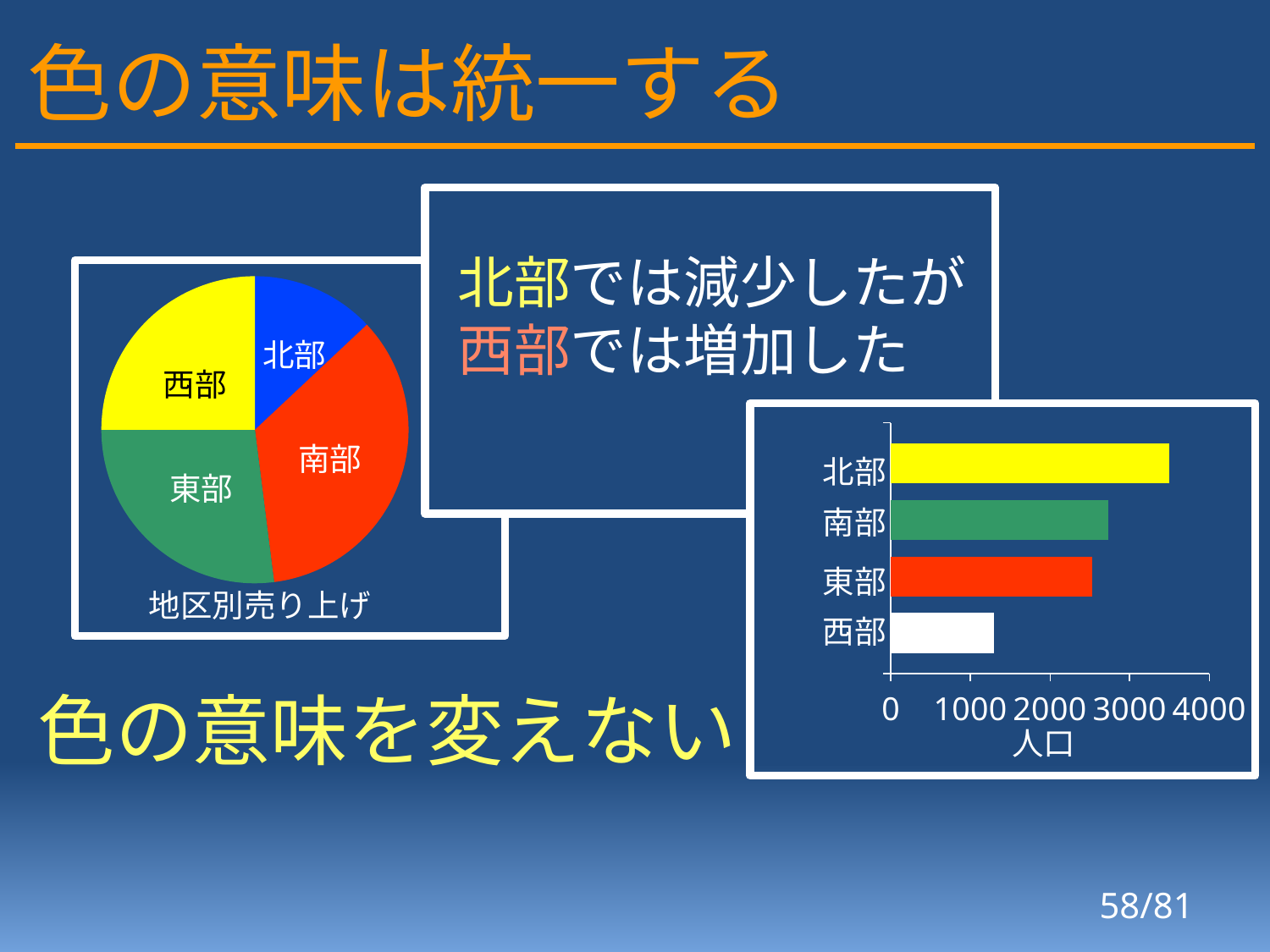
In the bar chart on the right, how many categories are shown? 4 In the pie chart titled 地区別売り上げ, how many slices are there? 4 In the pie chart titled 地区別売り上げ, which region has the smallest slice? 北部 In the bar chart on the right, is the value for 西部 greater or less than 2000? less In the bar chart on the right, which is larger, the value for 北部 or the value for 西部? 北部 In the pie chart titled 地区別売り上げ, which region has the largest slice? 南部 In the bar chart on the right, which region has the highest 人口 value? 北部 What kind of chart is the chart titled 地区別売り上げ on the left of the slide? pie chart In the bar chart on the right, which region has the lowest 人口 value? 西部 What kind of chart is the chart on the right of the slide with the 人口 axis? bar chart In the bar chart on the right, is the value for 北部 greater or less than 3000? greater What is the label on the horizontal axis of the bar chart on the right? 人口